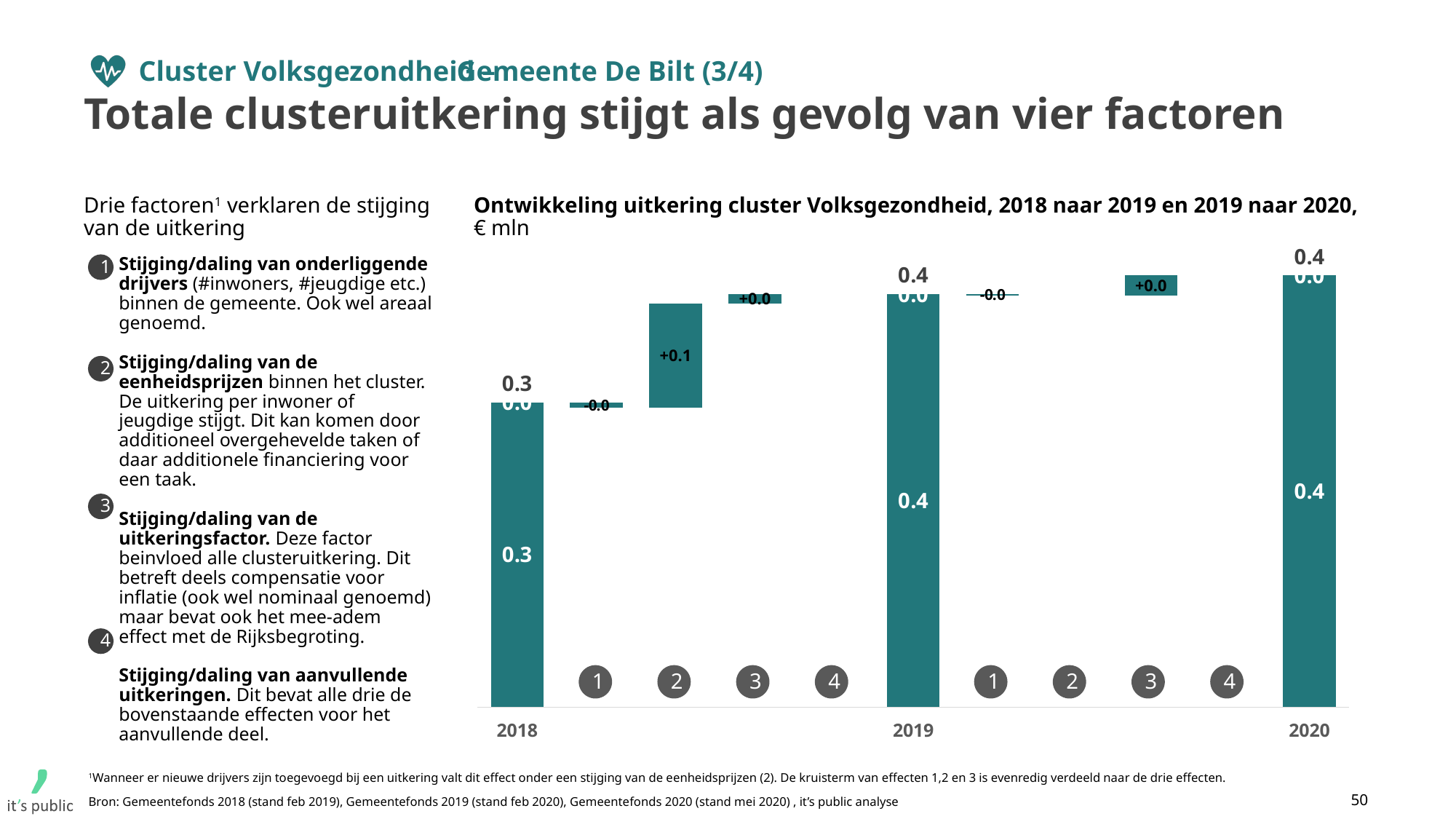
What kind of chart is shown on the slide? bar chart (waterfall) What unit is stated in the chart title? € mln What is the value of the factor 2 step between 2018 and 2019? +0.1 What is the value of the factor 3 step between 2019 and 2020? +0.0 Does the total uitkering rise or fall from 2018 to 2019? rise Which year has the lowest total uitkering: 2018, 2019 or 2020? 2018 What is the total uitkering for 2020 shown at the top of the 2020 bar? 0.4 What is the value of the factor 1 step between 2018 and 2019? -0.0 What is the difference between the 2019 total and the 2018 total? 0.1 What is the total uitkering for 2019 shown at the top of the 2019 bar? 0.4 What is the total uitkering for 2018 shown at the top of the 2018 bar? 0.3 Is the 2019 total larger or smaller than the 2018 total? larger